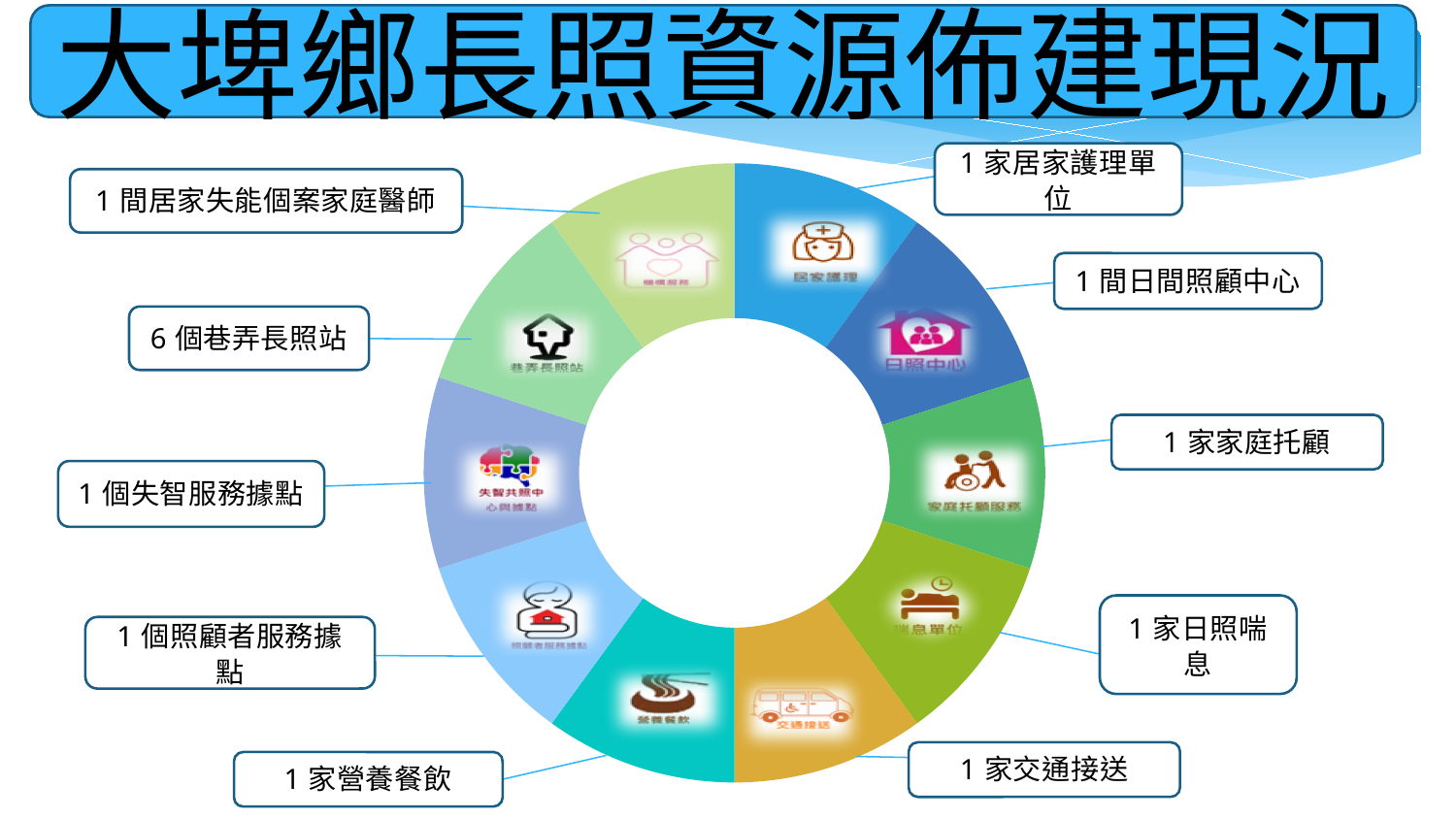
How many 交通接送 are listed on the slide? 1 家 How many segments does the ring diagram have? 10 What is the difference between the number of 巷弄長照站 and the number of 家庭托顧? 5 How many 照顧者服務據點 are listed on the slide? 1 個 Which is larger: the number of 巷弄長照站 or the number of 營養餐飲? 巷弄長照站 How many 巷弄長照站 are listed on the slide? 6 個 How many 失智服務據點 are listed on the slide? 1 個 How many 居家護理單位 are listed on the slide? 1 家 Which resource type has the highest count on the slide? 巷弄長照站 What is the title of the slide's diagram? 大埔鄉長照資源佈建現況 How many 日間照顧中心 are listed on the slide? 1 間 What kind of chart is shown on the slide? donut (ring) diagram